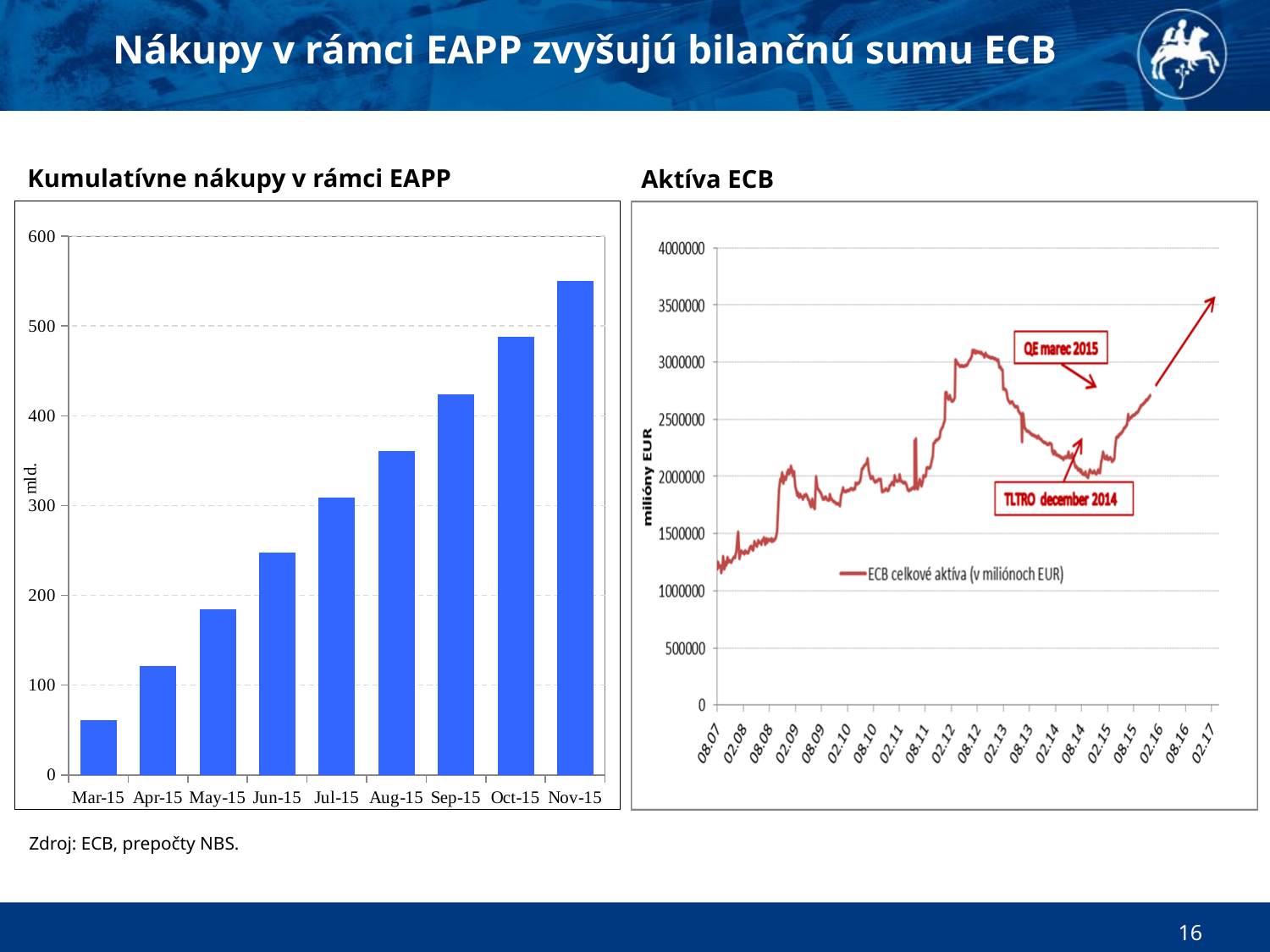
What kind of chart is the 'Aktíva ECB' chart? line chart In the 'Kumulatívne nákupy v rámci EAPP' chart, is the value for Jul-15 greater or less than 300? greater In the 'Kumulatívne nákupy v rámci EAPP' chart, is the value for Mar-15 greater or less than 100? less What kind of chart is the 'Kumulatívne nákupy v rámci EAPP' chart? bar chart How many months are shown on the x axis of the 'Kumulatívne nákupy v rámci EAPP' chart? 9 In the 'Kumulatívne nákupy v rámci EAPP' chart, is the value for Nov-15 greater or less than 500? greater In the 'Kumulatívne nákupy v rámci EAPP' chart, which month has the highest value? Nov-15 In the 'Kumulatívne nákupy v rámci EAPP' chart, do the values rise or fall from Mar-15 to Nov-15? rise In the 'Kumulatívne nákupy v rámci EAPP' chart, which month has the lowest value? Mar-15 How many series does the legend of the 'Aktíva ECB' chart list? 1 In the 'Kumulatívne nákupy v rámci EAPP' chart, which is larger, the value for Sep-15 or the value for Jun-15? Sep-15